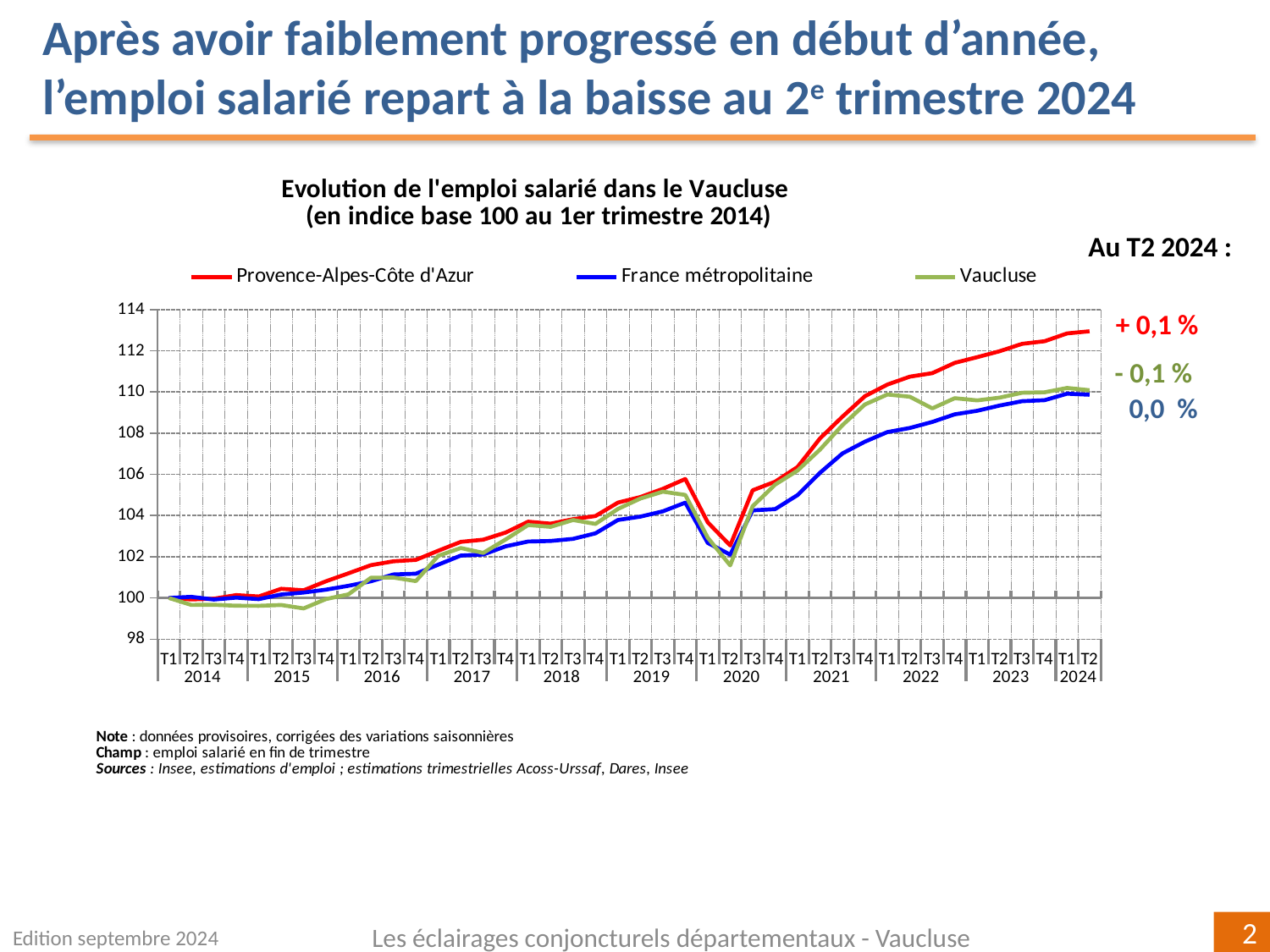
Which series is plotted in red? Provence-Alpes-Côte d'Azur Is the value for Provence-Alpes-Côte d'Azur at T4 2019 greater or less than 104? greater Is the value for France métropolitaine at T1 2021 greater or less than 106? less Which series has the highest value at T2 2024? Provence-Alpes-Côte d'Azur What is the title of the chart? Evolution de l'emploi salarié dans le Vaucluse (en indice base 100 au 1er trimestre 2014) Overall, do the series rise or fall from T1 2014 to T2 2024? rise At T2 2024, which is larger: the value for Provence-Alpes-Côte d'Azur or the value for France métropolitaine? Provence-Alpes-Côte d'Azur How many series does the legend list? 3 Which series has the lowest value at T3 2015? Vaucluse What kind of chart is shown on the slide? line chart Is the value for Vaucluse at T3 2015 greater or less than 100? less